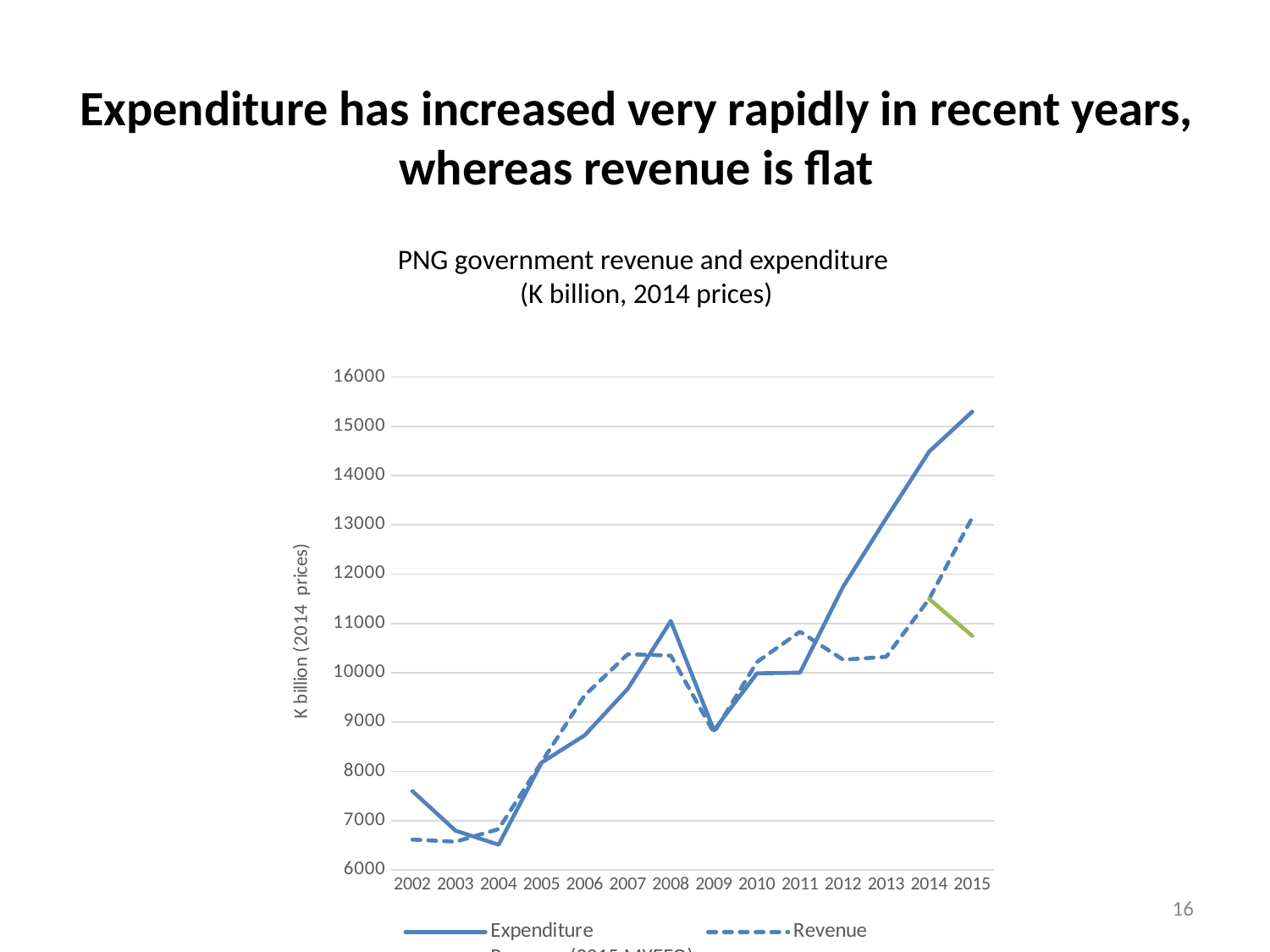
In which year is Expenditure highest? 2015 How many years are shown on the x axis of the chart? 14 Is the value for Expenditure in 2012 greater or less than 11000? greater Is the value for Revenue in 2011 greater or less than 10000? greater Is the value for Expenditure in 2015 greater or less than 15000? greater What is the label on the vertical axis of the chart? K billion (2014 prices) In which year is Expenditure lowest? 2004 Does Expenditure rise or fall between 2011 and 2015? Rise What kind of chart is shown on the slide? Line chart In 2015, which is larger, Expenditure or Revenue? Expenditure What is the title of the chart? PNG government revenue and expenditure (K billion, 2014 prices)